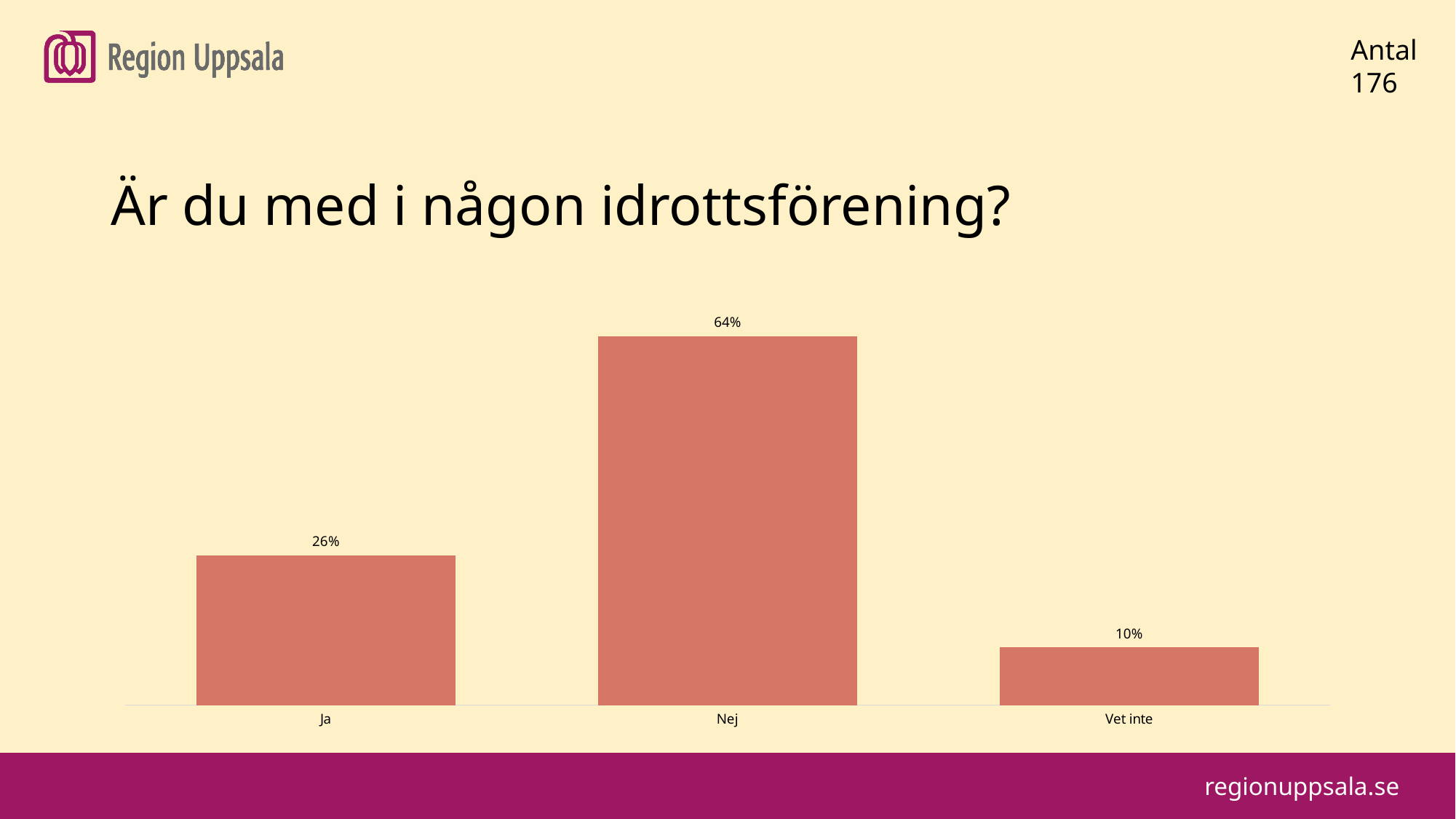
Which category has the highest value? Nej What is the difference between the values for "Ja" and "Vet inte"? 16% What is the value for "Nej"? 64% What is the value for "Vet inte"? 10% Which is larger, the value for "Ja" or the value for "Vet inte"? Ja Which category has the lowest value? Vet inte What is the value for "Ja"? 26% What is the question shown as the title above the chart? Är du med i någon idrottsförening? What is the difference between the values for "Nej" and "Ja"? 38% What kind of chart is shown on the slide? Bar chart What number of respondents (Antal) is shown on the slide? 176 How many categories are shown on the x axis? 3